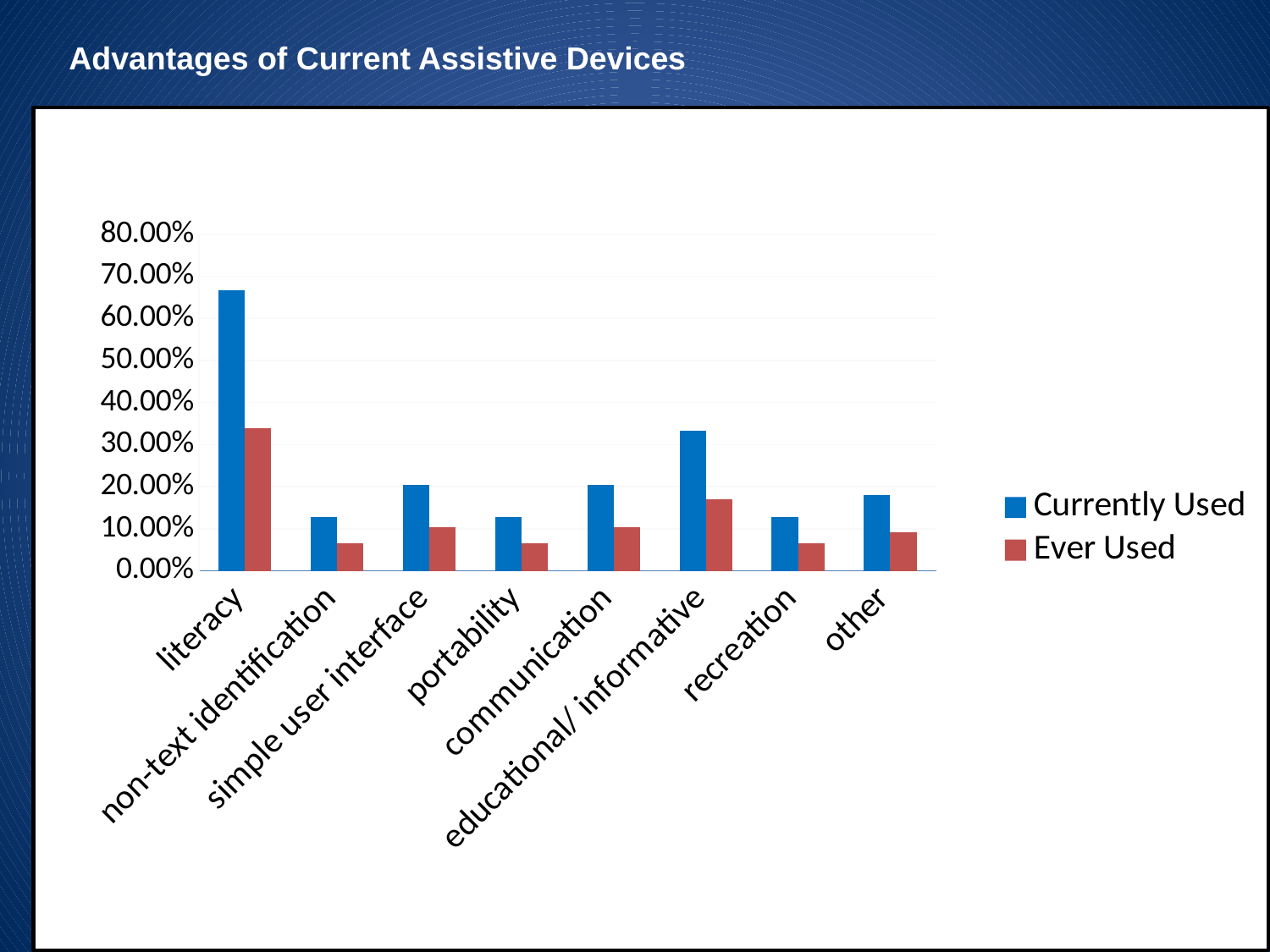
Which is larger: the Currently Used value for literacy or the Currently Used value for educational/ informative? literacy Is the Currently Used value for non-text identification greater or less than 20.00%? less Is the Currently Used value for literacy greater or less than 60.00%? greater How many categories are shown on the x axis? 8 Is the Ever Used value for literacy greater or less than 30.00%? greater Which category has the highest Ever Used value? literacy Which is larger for communication: the Currently Used value or the Ever Used value? Currently Used How many series does the legend list? 2 Which category has the highest Currently Used value? literacy Which series is shown in blue in the legend? Currently Used What kind of chart is shown on the slide? bar chart